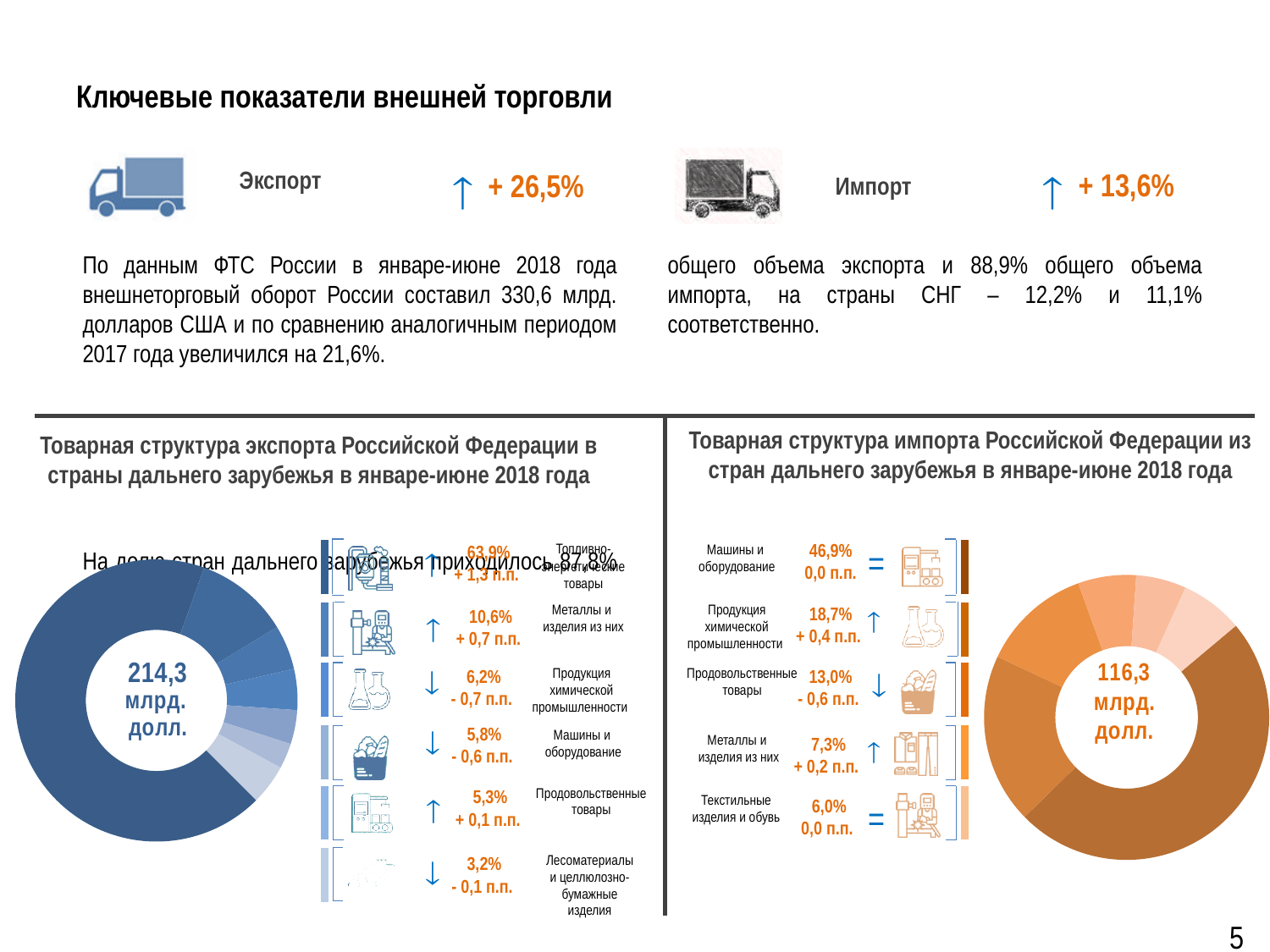
How many categories are labelled in the import structure chart? 5 In the export structure chart (left), what total value is shown in the centre of the donut? 214,3 млрд. долл. In the export structure chart, what share is shown for Металлы и изделия из них? 10,6% What kind of chart is used on the slide to show the commodity structure of exports and imports? pie chart (donut) In the import structure chart (right), what total value is shown in the centre of the donut? 116,3 млрд. долл. In the import structure chart, what is the difference between the shares of Машины и оборудование and Продукция химической промышленности? 28,2 п.п. In the import structure chart, what share is shown for Продукция химической промышленности? 18,7% In the export structure chart, what change in percentage points is shown for Продукция химической промышленности? - 0,7 п.п. In the import structure chart, what share is shown for Машины и оборудование? 46,9% In the import structure chart, which category has the largest share? Машины и оборудование In the import structure chart, which labelled category has the smallest share? Текстильные изделия и обувь In the export structure chart, which has the larger share: Машины и оборудование or Продовольственные товары? Машины и оборудование